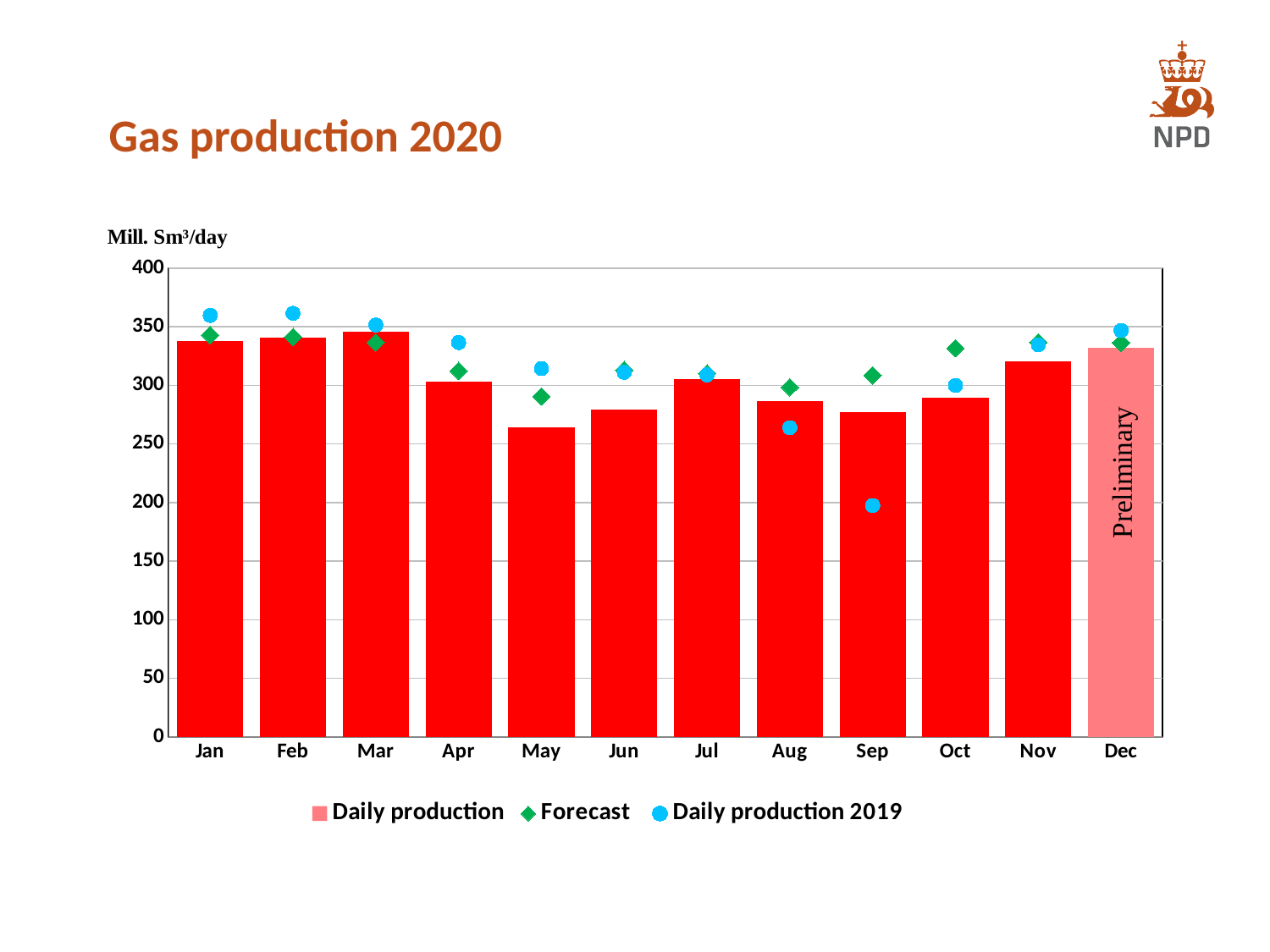
Which month has the lowest Daily production 2019 value? Sep Is the Daily production 2019 value for Sep greater or less than 250? less How many series does the legend list? 3 Is the Daily production value for Nov greater or less than 300? greater Which is larger, the Daily production bar for Jan or for May? Jan What is the title of the chart? Gas production 2020 Is the Daily production value for May greater or less than 300? less What label is written on the Dec bar? Preliminary What kind of chart is used to show Daily production? bar chart Which is larger in Oct, the Forecast value or the Daily production bar? Forecast Which month has the lowest Daily production bar? May How many months are shown on the x axis? 12